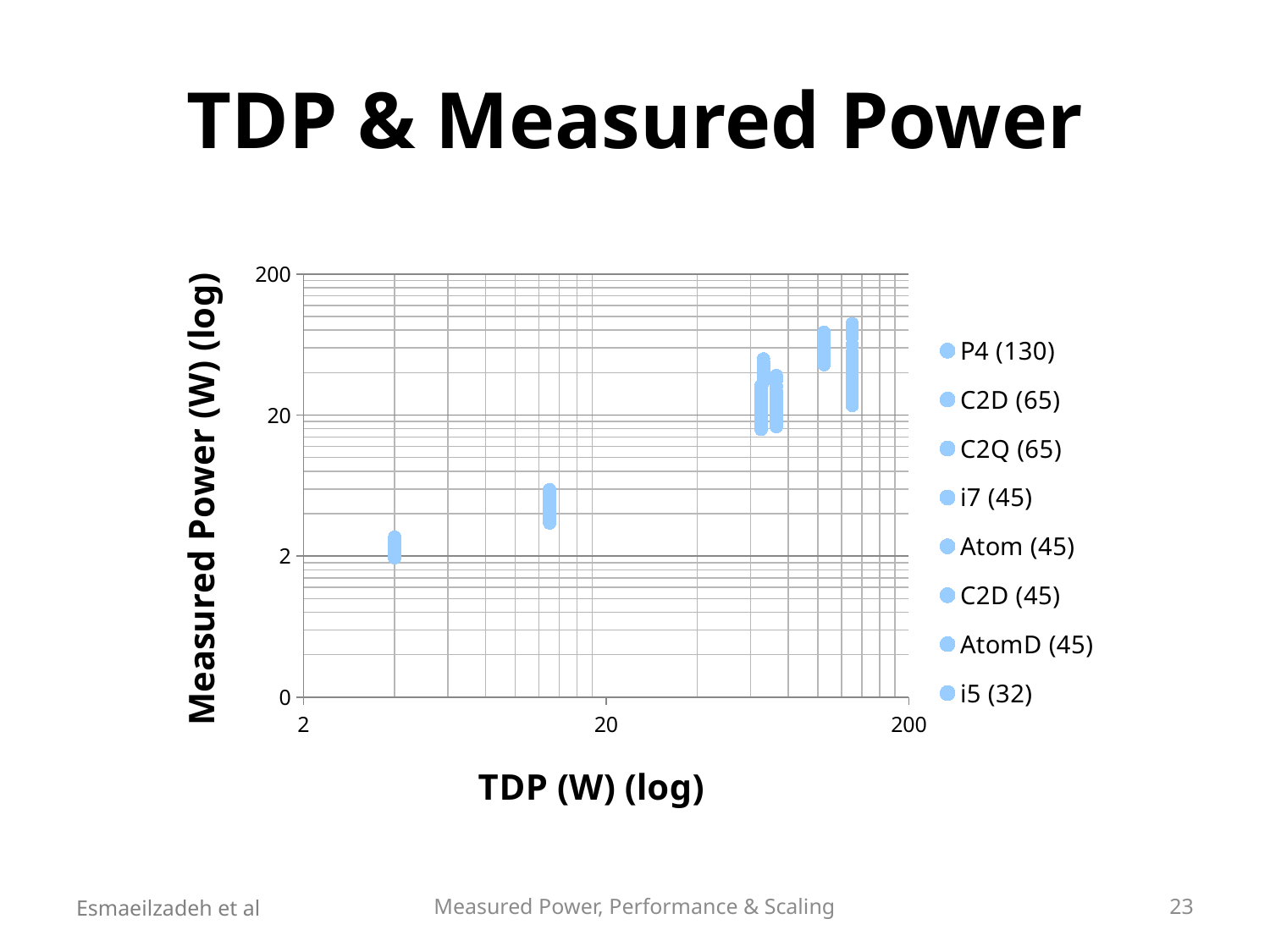
What is the title of the chart on the slide? TDP & Measured Power How many series does the chart's legend list? 8 As TDP increases along the x axis, does measured power generally rise or fall? rise What kind of chart is shown on the slide? scatter chart Which legend entry is listed last in the chart's legend? i5 (32) Which legend entry is listed first in the chart's legend? P4 (130) What is the highest tick value shown on the y axis of the chart? 200 What is the lowest tick value shown on the x axis of the chart? 2